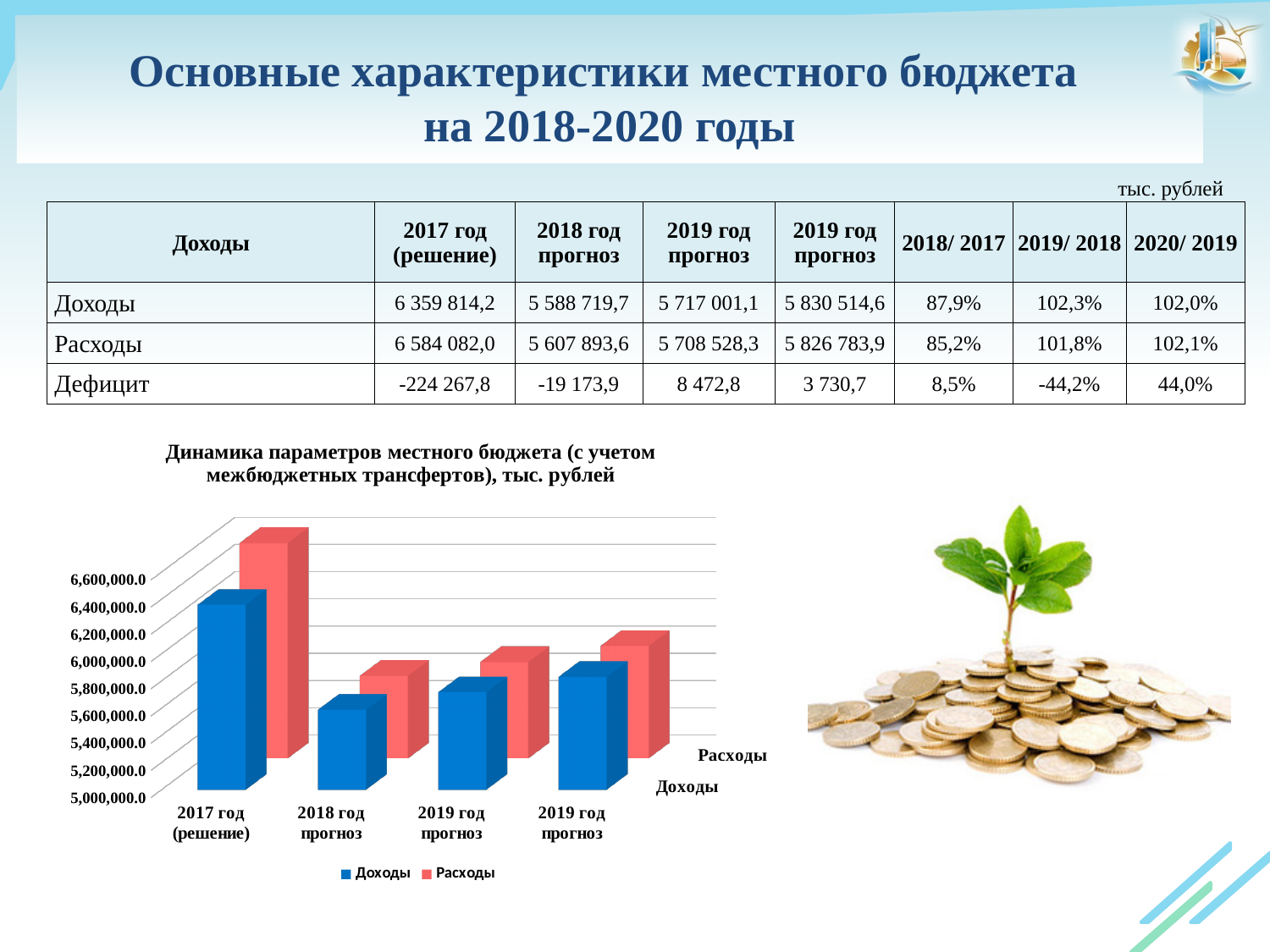
How many categories are shown along the x axis of the chart? 4 What is the title of the chart? Динамика параметров местного бюджета (с учетом межбюджетных трансфертов), тыс. рублей Which series is shown in blue in the chart? Доходы For which category is the Расходы bar the highest in the chart? 2017 год (решение) Do the Доходы bars rise or fall from 2018 год прогноз to the last category in the chart? rise In the chart, is the Расходы value for the last (fourth) category greater or less than 6,200,000.0? less How many series does the chart legend list? 2 What kind of chart is shown on the slide? bar chart In the chart, is the Доходы value for 2017 год (решение) greater or less than 6,200,000.0? greater For which category is the Доходы bar the lowest in the chart? 2018 год прогноз For 2017 год (решение), which is larger in the chart: Доходы or Расходы? Расходы